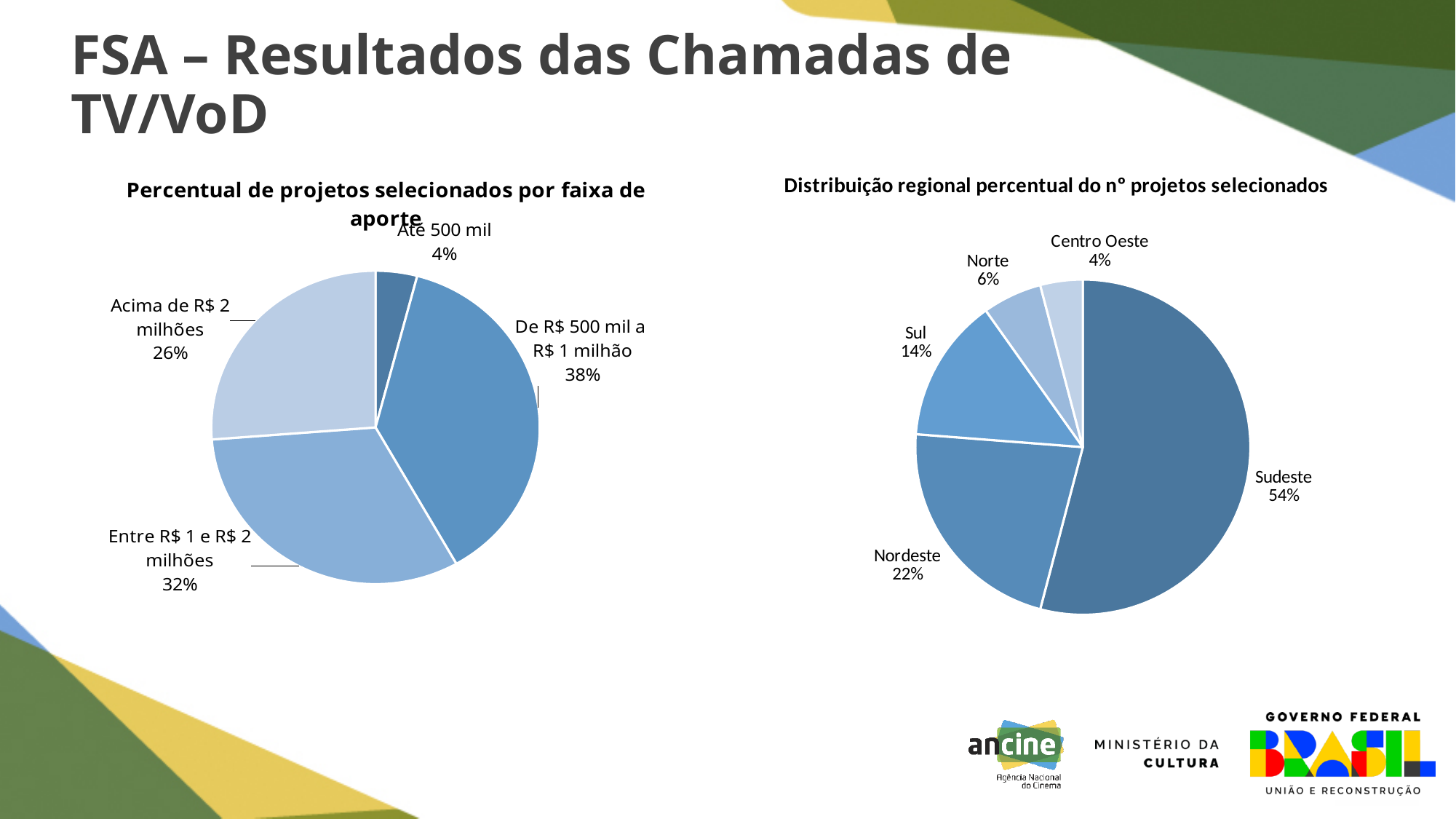
In the right pie chart (Distribuição regional percentual do nº projetos selecionados), which region has the smallest share? Centro Oeste In the left pie chart (Percentual de projetos selecionados por faixa de aporte), what is the difference in percentage points between 'Entre R$ 1 e R$ 2 milhões' and 'Acima de R$ 2 milhões'? 6 percentage points In the right pie chart (Distribuição regional percentual do nº projetos selecionados), what is the difference in percentage points between Sudeste and Nordeste? 32 percentage points In the left pie chart (Percentual de projetos selecionados por faixa de aporte), how many funding ranges are shown? 4 In the right pie chart (Distribuição regional percentual do nº projetos selecionados), which is larger, Nordeste or Sul? Nordeste In the left pie chart (Percentual de projetos selecionados por faixa de aporte), which funding range has the smallest share? Até 500 mil In the left pie chart (Percentual de projetos selecionados por faixa de aporte), what share of projects is in the 'De R$ 500 mil a R$ 1 milhão' range? 38% What type of chart is used for the 'Distribuição regional percentual do nº projetos selecionados' chart? Pie chart In the right pie chart (Distribuição regional percentual do nº projetos selecionados), what share of selected projects is from Sudeste? 54% In the left pie chart (Percentual de projetos selecionados por faixa de aporte), which funding range has the largest share? De R$ 500 mil a R$ 1 milhão In the right pie chart (Distribuição regional percentual do nº projetos selecionados), how many regions are shown? 5 In the right pie chart (Distribuição regional percentual do nº projetos selecionados), what is the share for Norte? 6%